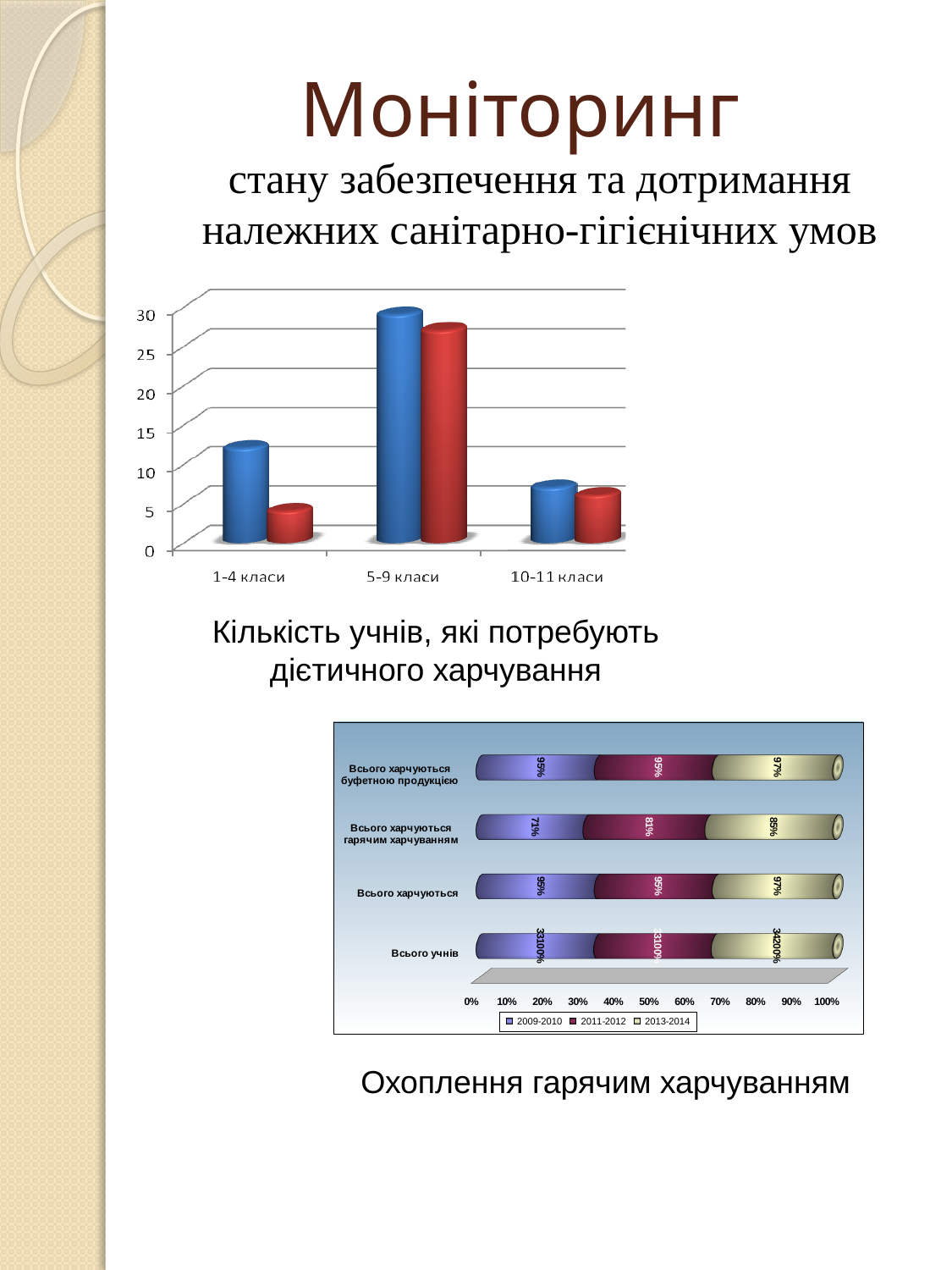
In the top chart (Кількість учнів, які потребують дієтичного харчування), for 1-4 класи, which bar is taller, the blue one or the red one? the blue one In the bottom chart (Охоплення гарячим харчуванням), what is the difference between the 2013-2014 and 2009-2010 values for 'Всього харчуються гарячим харчуванням'? 14% In the top chart (Кількість учнів, які потребують дієтичного харчування), which category has the tallest bar? 5-9 класи In the top chart (Кількість учнів, які потребують дієтичного харчування), is the blue bar for 5-9 класи greater or less than 25? greater How many categories are shown on the x axis of the top chart (Кількість учнів, які потребують дієтичного харчування)? 3 How many series does the legend of the bottom chart (Охоплення гарячим харчуванням) list? 3 In the top chart (Кількість учнів, які потребують дієтичного харчування), is the red bar for 1-4 класи greater or less than 5? less In the top chart (Кількість учнів, які потребують дієтичного харчування), is the blue bar for 10-11 класи greater or less than 10? less In the bottom chart (Охоплення гарячим харчуванням), what is the value for 'Всього харчуються гарячим харчуванням' in 2013-2014? 85% What kind of chart is the top chart (Кількість учнів, які потребують дієтичного харчування)? bar chart In the bottom chart (Охоплення гарячим харчуванням), do the values for 'Всього харчуються гарячим харчуванням' rise or fall from 2009-2010 to 2013-2014? rise In the bottom chart (Охоплення гарячим харчуванням), what is the value for 'Всього харчуються гарячим харчуванням' in 2009-2010? 71%